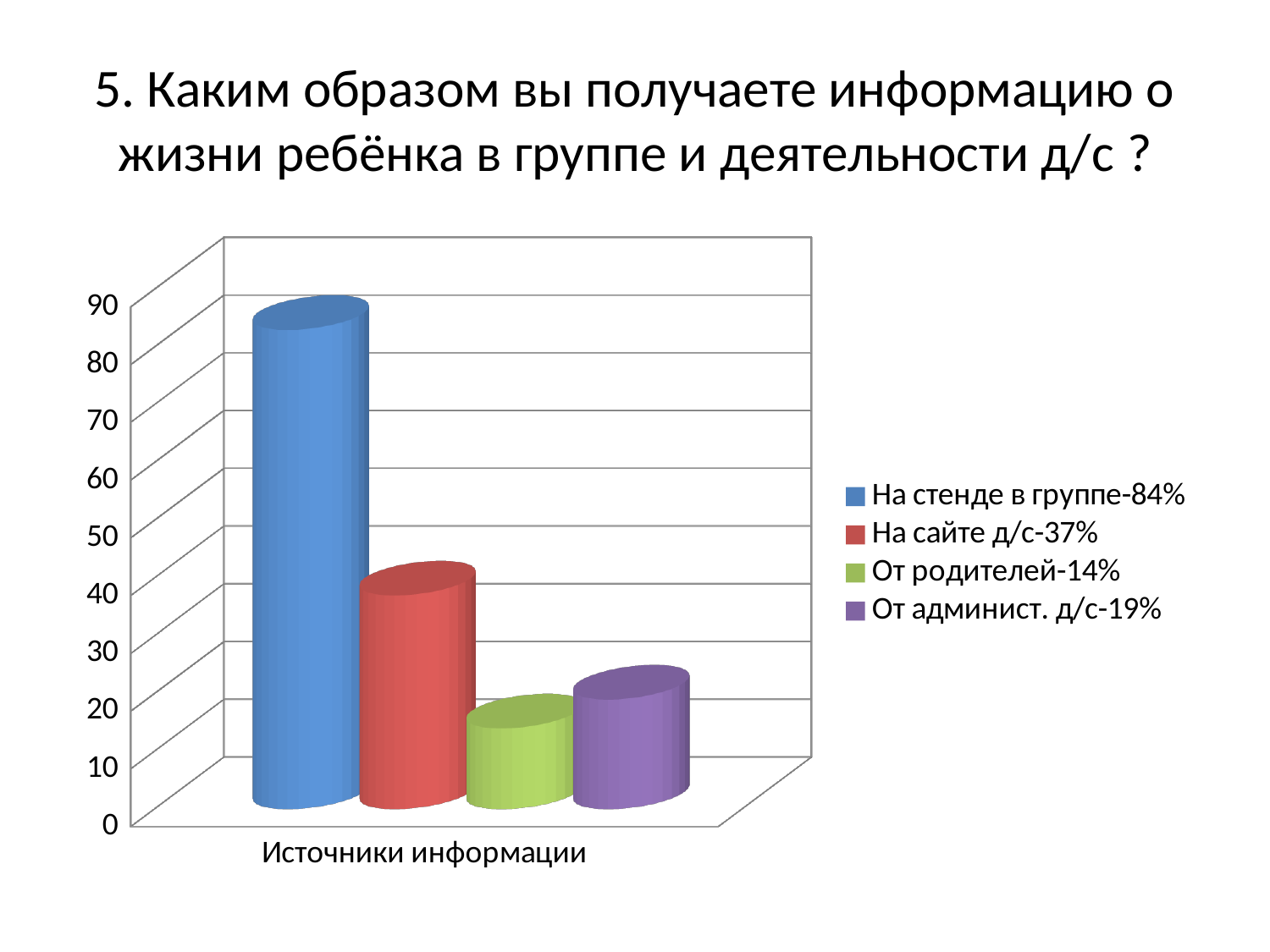
What is the difference between the values for 'На стенде в группе' and 'На сайте д/с'? 47% How many series does the legend list? 4 Which source of information has the lowest value? От родителей What is the value for 'На сайте д/с' according to the legend? 37% What is the value for 'От родителей' according to the legend? 14% What is the value for 'От админист. д/с' according to the legend? 19% What kind of chart is shown on the slide? bar chart Is the value for 'На сайте д/с' greater or less than 40? less What is the value for 'На стенде в группе' according to the legend? 84% Which is larger: the value for 'От админист. д/с' or the value for 'От родителей'? От админист. д/с Which source of information has the highest value? На стенде в группе What is the category label shown on the x axis? Источники информации